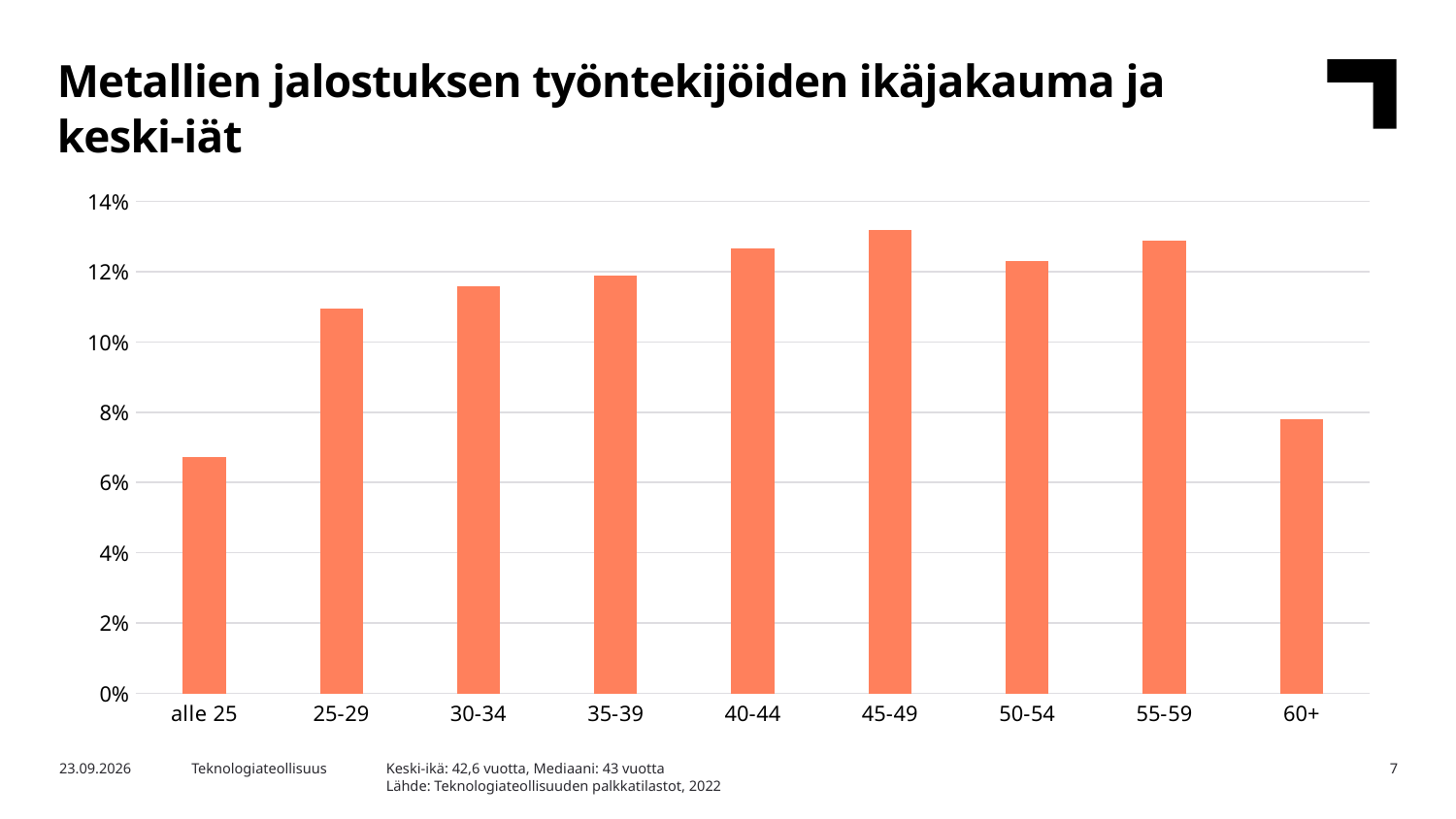
According to the footnote, what is the average age (keski-ikä) of the workers? 42,6 vuotta Is the value for 25-29 greater or less than 10%? greater Is the value for 60+ greater or less than 6%? greater Do the values rise or fall from alle 25 to 45-49? rise Which is larger, the value for 55-59 or the value for 50-54? 55-59 Is the value for alle 25 greater or less than 8%? less Which age group has the lowest share of workers? alle 25 What kind of chart is shown on the slide? bar chart Which is larger, the value for 60+ or the value for alle 25? 60+ Which age group has the highest share of workers? 45-49 How many age groups are shown on the x axis? 9